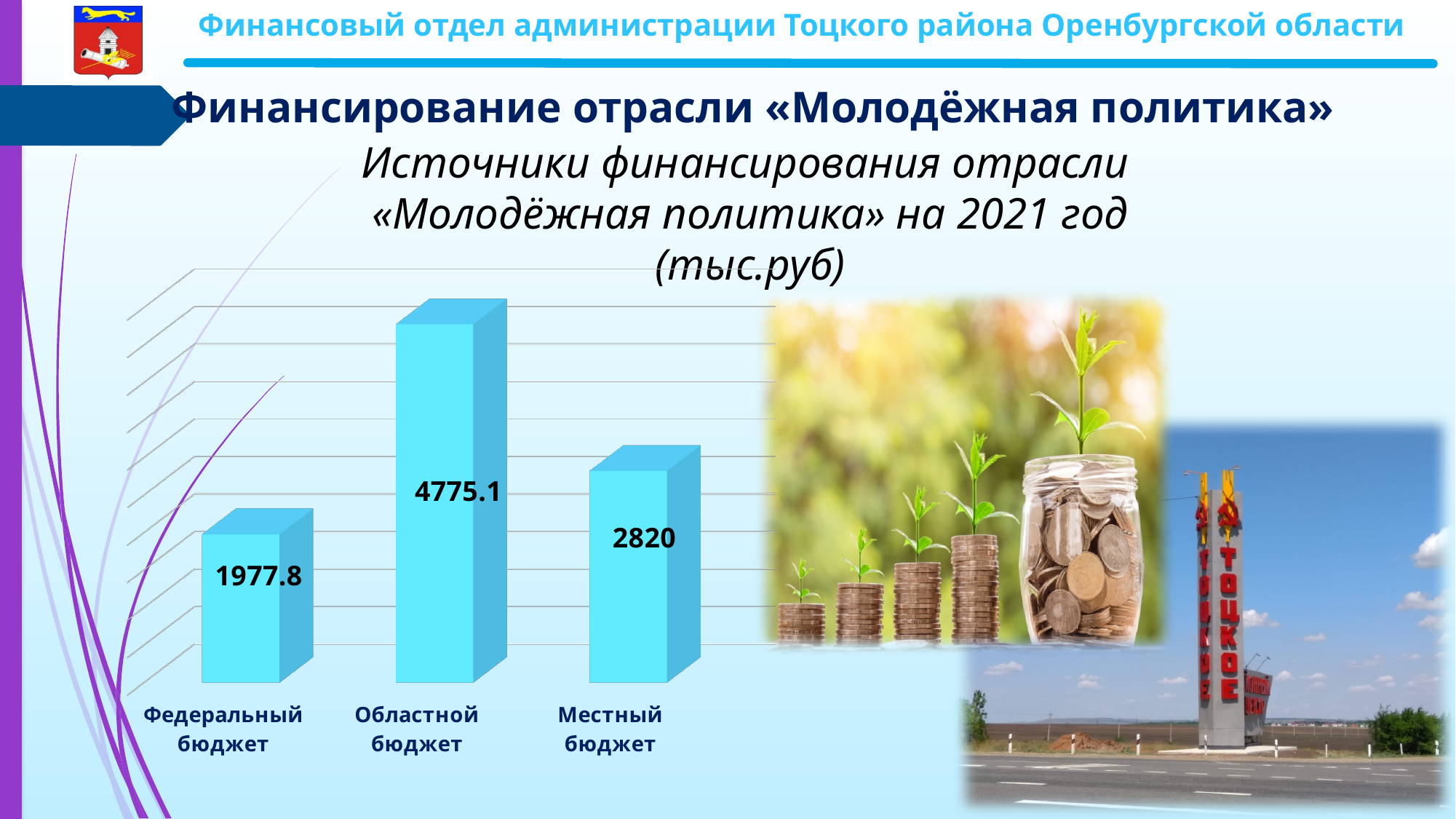
What is the difference between Местный бюджет and Федеральный бюджет? 842.2 Which funding source has the lowest value? Федеральный бюджет How many funding sources are shown in the chart? 3 What is the value for Федеральный бюджет? 1977.8 What is the difference between Областной бюджет and Местный бюджет? 1955.1 What is the value for Областной бюджет? 4775.1 In what units are the chart values given, according to the chart title? тыс.руб Which is larger, Местный бюджет or Федеральный бюджет? Местный бюджет Which funding source has the highest value? Областной бюджет What is the value for Местный бюджет? 2820 What is the difference between Областной бюджет and Федеральный бюджет? 2797.3 What kind of chart is shown on the slide? Bar chart